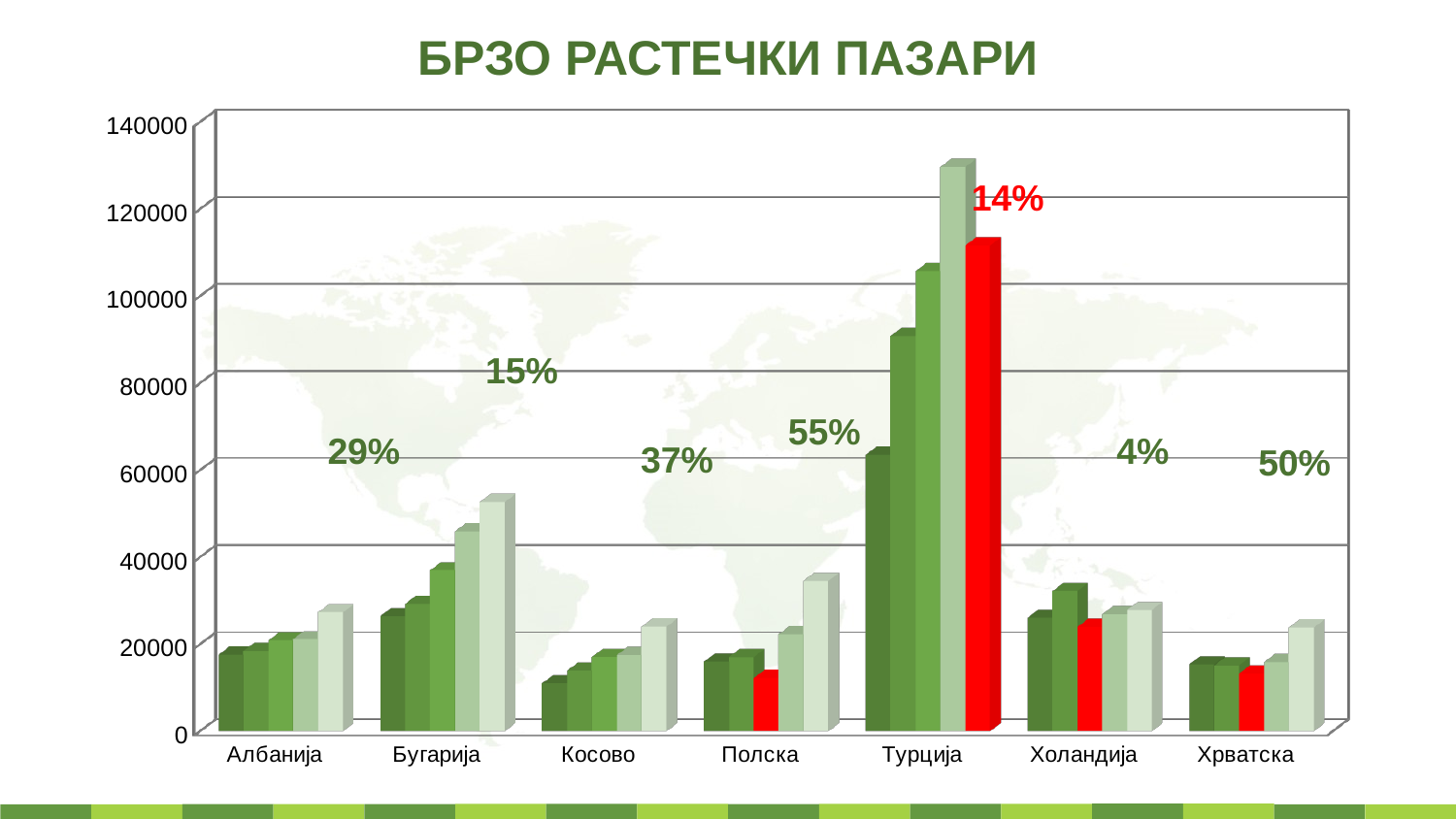
Which country has the tallest bar in the chart? Турција Is the tallest bar for Албанија greater or less than 40000? less What percentage label is printed above the bars for Холандија? 4% What kind of chart is shown on the slide? bar chart Which country has taller bars overall, Турција or Бугарија? Турција What percentage label is printed above the bars for Полска? 55% Is the tallest bar for Турција greater or less than 120000? greater Is the tallest bar for Бугарија greater or less than 60000? less How many bars are plotted for each country in the chart? 5 How many countries are shown on the x axis of the chart? 7 What is the title of the chart on the slide? БРЗО РАСТЕЧКИ ПАЗАРИ